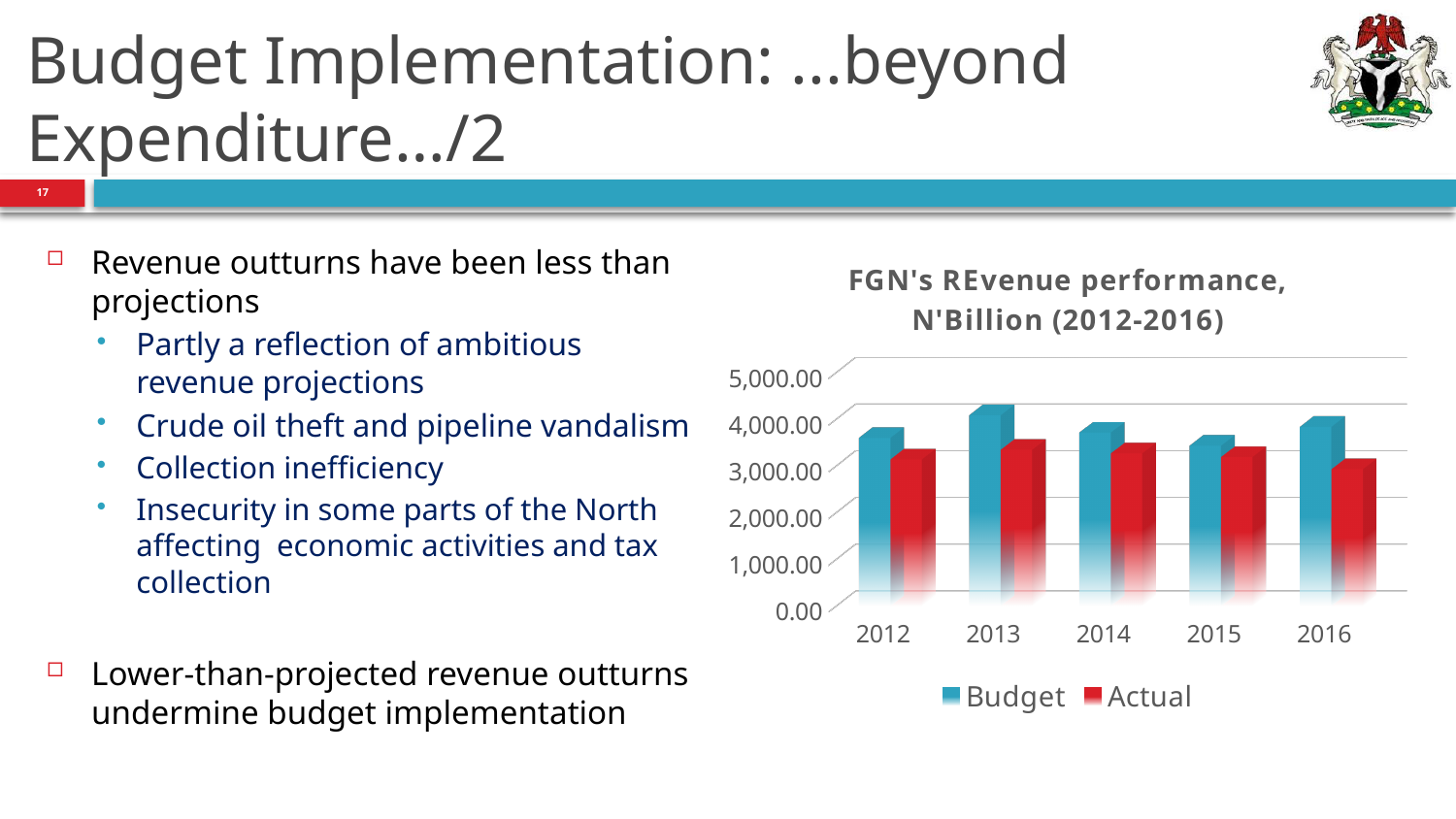
In which year is the Budget value highest? 2013 What is the title of the chart? FGN's REvenue performance, N'Billion (2012-2016) How many years are shown on the x axis of the chart? 5 What kind of chart is shown on the slide? Bar chart Is the Budget value for 2015 greater or less than 4,000.00? less Is the Actual value for 2016 greater or less than 2,000.00? greater How many series does the chart's legend list? 2 In 2016, which is larger, the Budget value or the Actual value? Budget Is the Actual value for 2014 greater or less than 4,000.00? less What are the two series named in the chart's legend? Budget and Actual In 2013, which is larger, the Budget value or the Actual value? Budget